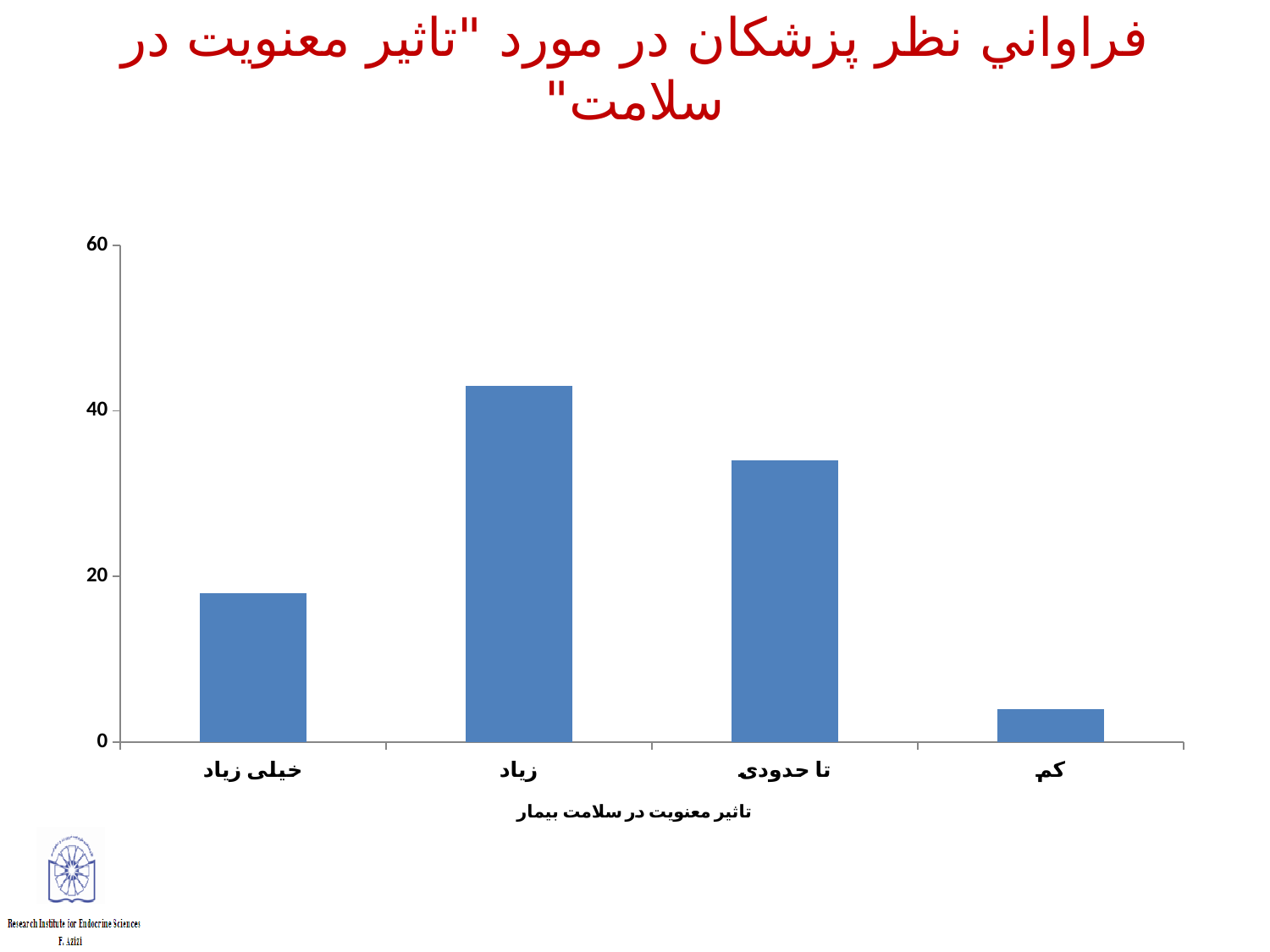
Is the value for تا حدودی greater or less than 40? less What is the label of the x axis of the chart? تاثیر معنویت در سلامت بیمار Is the value for تا حدودی greater or less than 20? greater Is the value for زیاد greater or less than 40? greater Which is larger, the value for زیاد or the value for تا حدودی? زیاد Do the values rise or fall along the x axis from زیاد to کم? fall What kind of chart is shown on the slide? bar chart Which category has the lowest bar in the chart? کم Which category has the highest bar in the chart? زیاد How many categories are shown on the x axis of the chart? 4 Which is larger, the value for خیلی زیاد or the value for کم? خیلی زیاد